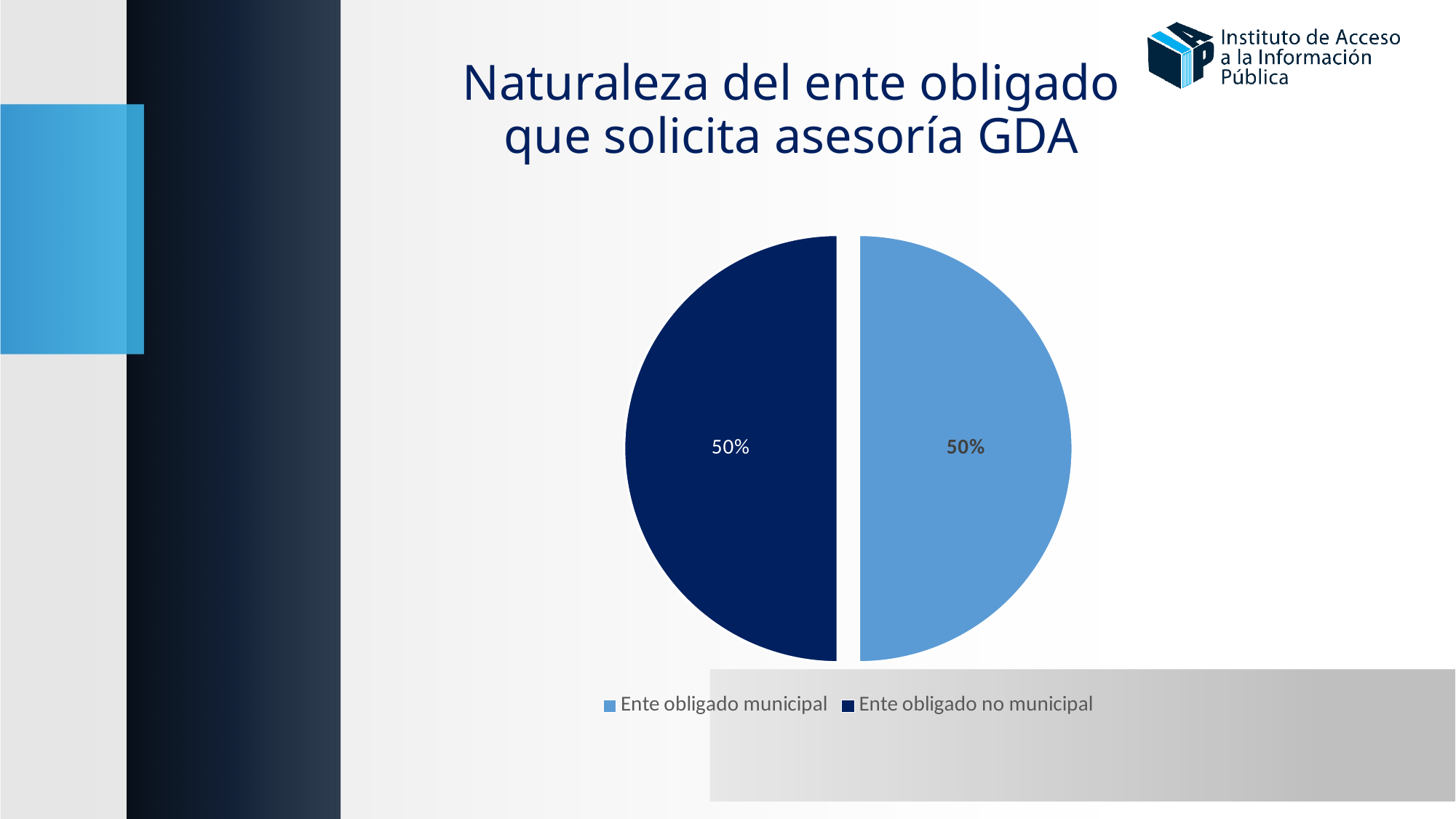
Which legend entry is shown in dark navy blue? Ente obligado no municipal What is the difference between the "Ente obligado municipal" and "Ente obligado no municipal" shares? 0% What is the value shown for the "Ente obligado no municipal" slice? 50% What kind of chart is shown on the slide? pie chart How many entries does the legend list? 2 What share of the pie does "Ente obligado no municipal" represent? 50% What is the title of the chart on the slide? Naturaleza del ente obligado que solicita asesoría GDA What is the value shown for the "Ente obligado municipal" slice? 50% What share of the pie does "Ente obligado municipal" represent? 50% How many slices does the pie chart have? 2